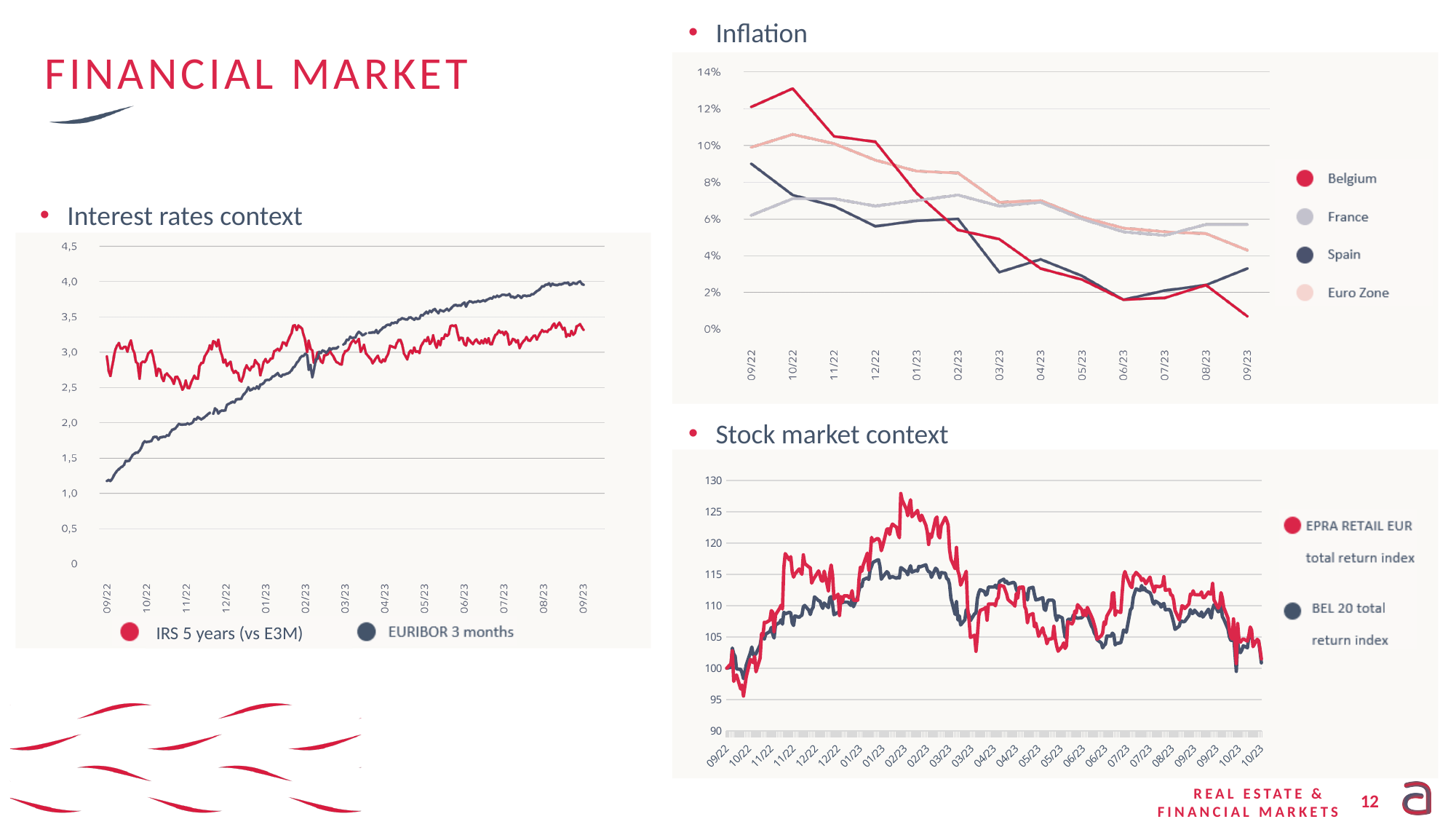
On the Inflation chart, does the Belgium line generally rise or fall from 10/22 to 09/23? fall On the Interest rates context chart, is the value for EURIBOR 3 months at 09/22 greater or less than 1,5? less On the Inflation chart, how many series does the legend list? 4 On the Interest rates context chart, does the EURIBOR 3 months line rise or fall over the period shown? rise On the Inflation chart, is the value for Belgium at 10/22 greater or less than 12%? greater What kind of chart is the Stock market context chart? line chart On the Interest rates context chart, which series is higher at 09/23, IRS 5 years (vs E3M) or EURIBOR 3 months? EURIBOR 3 months On the Inflation chart, how many month labels are shown on the x axis? 13 On the Inflation chart, is the value for Belgium at 09/23 greater or less than 2%? less On the Inflation chart, which series has the highest value at 10/22? Belgium